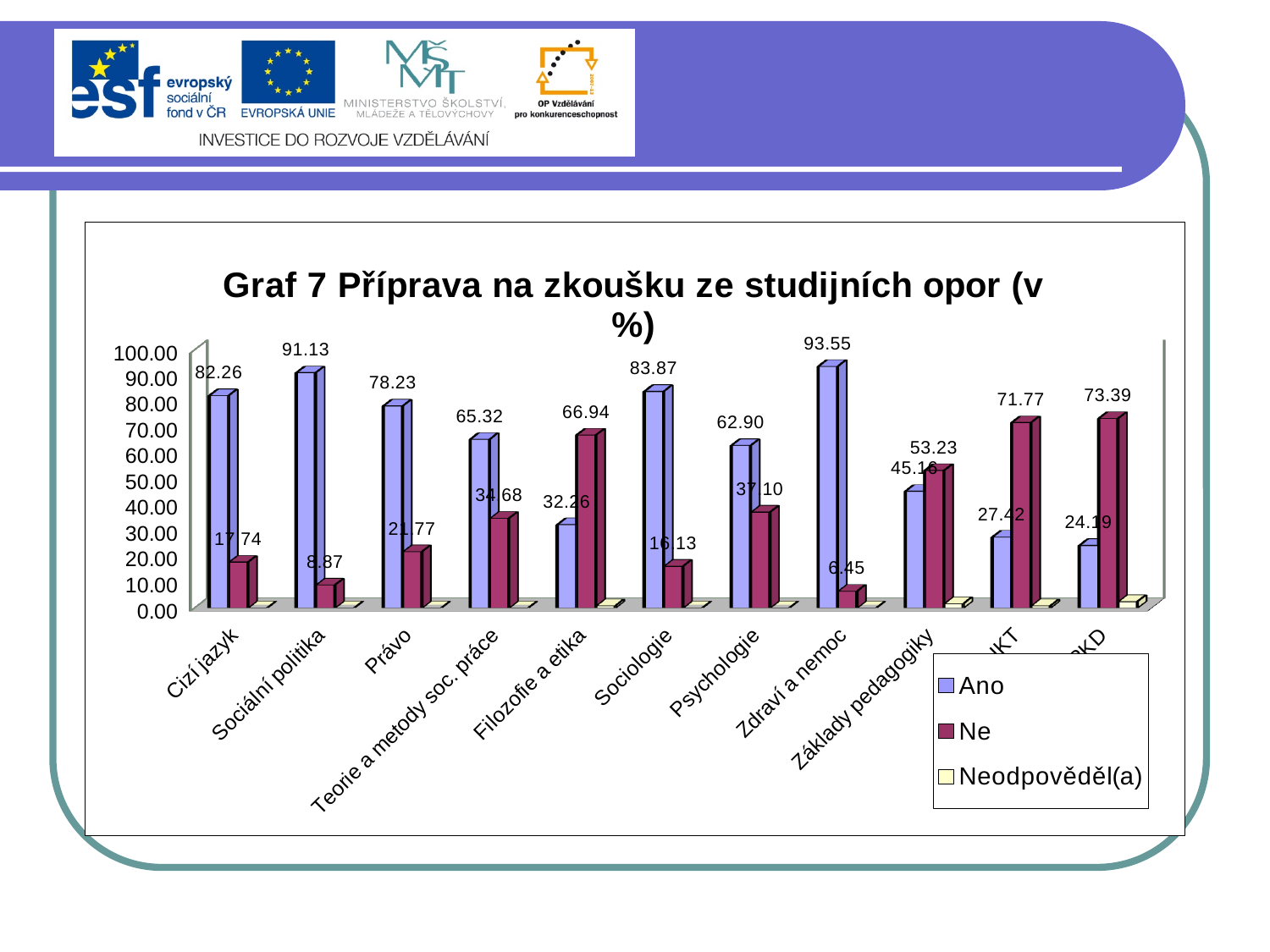
Which category has the highest value in the Ano series? Zdraví a nemoc What is the value of the Ne series for Filozofie a etika? 66.94 Which category has the lowest value in the Ne series? Zdraví a nemoc What is the value of the Ano series for Sociální politika? 91.13 Which is larger for Právo, the Ano value or the Ne value? Ano What is the difference between the Ano and Ne values for Cizí jazyk? 64.52 How many series does the legend list? 3 What is the title of the chart? Graf 7 Příprava na zkoušku ze studijních opor (v %) What is the value of the Ano series for Psychologie? 62.90 Is the Ano value for Teorie a metody soc. práce greater or less than 60.00? greater What is the value of the Ne series for Základy pedagogiky? 53.23 What kind of chart is shown on the slide? Bar chart